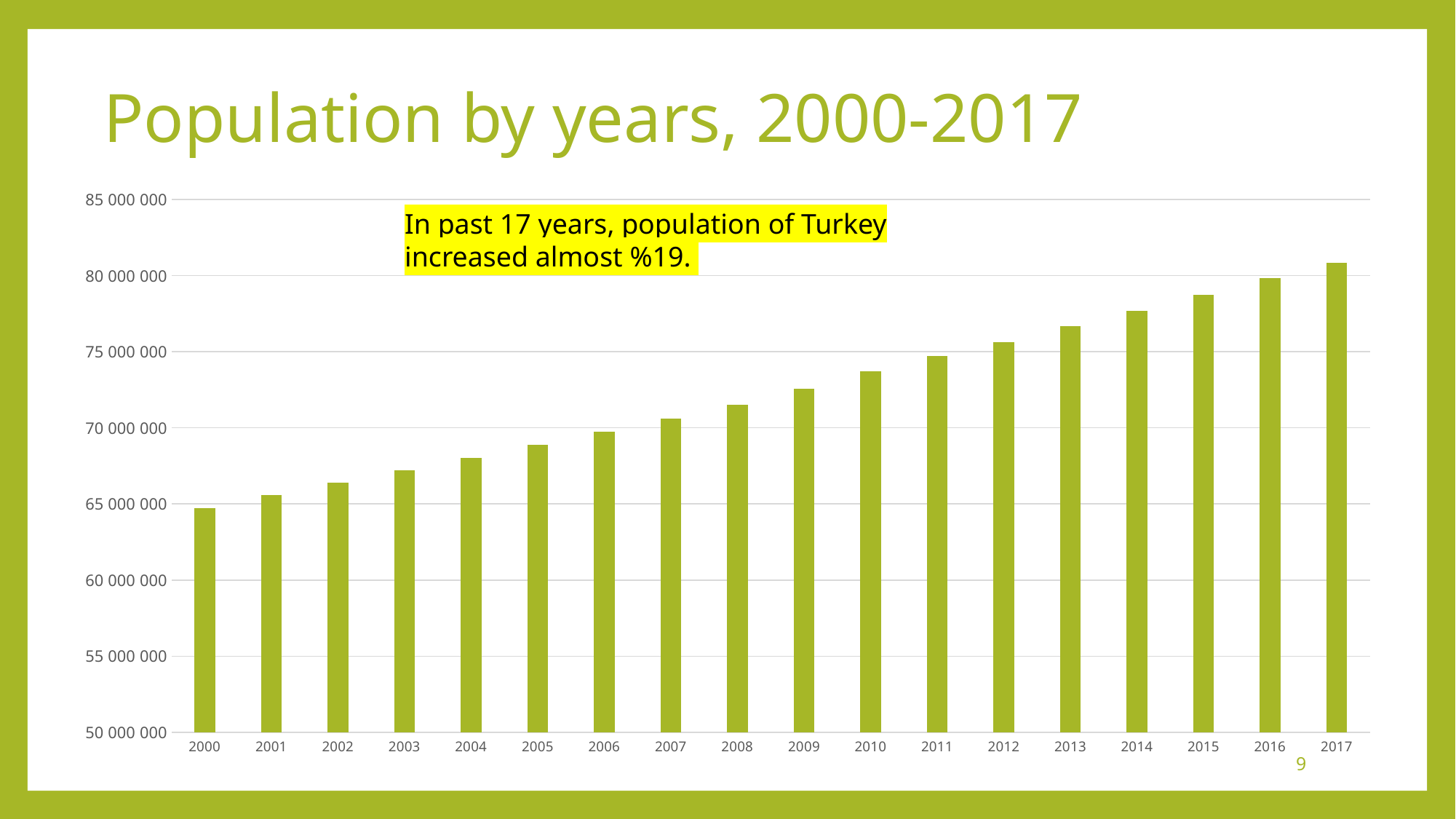
Is the population for 2014 greater or less than 80 000 000? less Which year has the highest population? 2017 What is the title of the slide containing the chart? Population by years, 2000-2017 Is the population for 2004 greater or less than 65 000 000? greater Is the population for 2017 greater or less than 80 000 000? greater Which year has the lowest population? 2000 How many years are plotted on the chart? 18 What kind of chart is shown on the slide? bar chart Do the population values rise or fall from 2000 to 2017? rise Which year has the larger population, 2005 or 2010? 2010